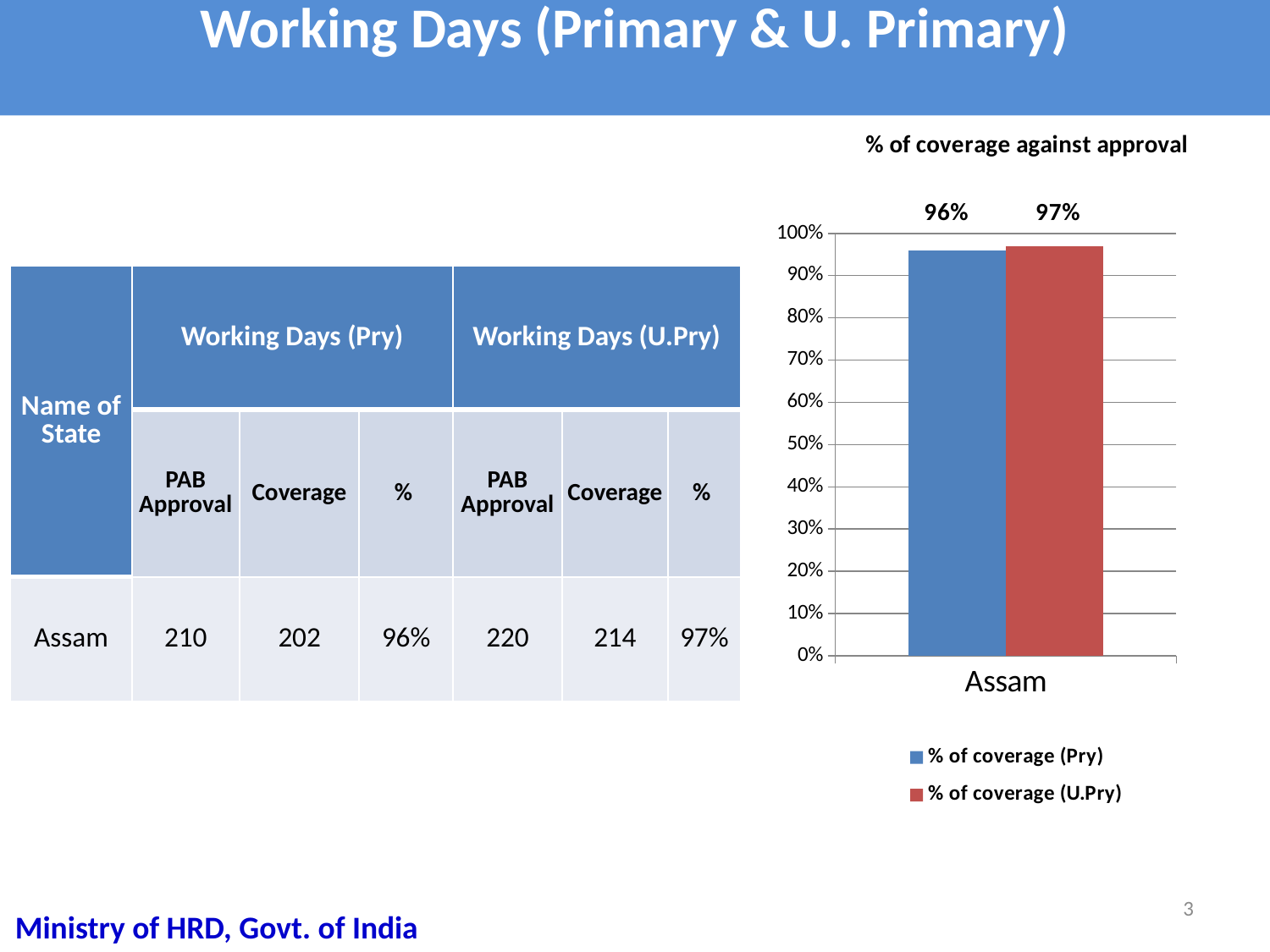
What is the difference between % of coverage (U.Pry) and % of coverage (Pry) for Assam? 1% How many categories are shown on the x axis of the chart? 1 What is the title of the chart? % of coverage against approval What is the value of % of coverage (Pry) for Assam? 96% What is the value of % of coverage (U.Pry) for Assam? 97% Is the value of % of coverage (Pry) for Assam greater or less than 90%? greater What kind of chart is shown on the slide? bar chart Which category is shown on the x axis of the chart? Assam Which series has the higher value for Assam, % of coverage (Pry) or % of coverage (U.Pry)? % of coverage (U.Pry) How many series does the chart legend list? 2 Which series is shown in red in the chart? % of coverage (U.Pry) Is the value of % of coverage (U.Pry) for Assam greater or less than 100%? less